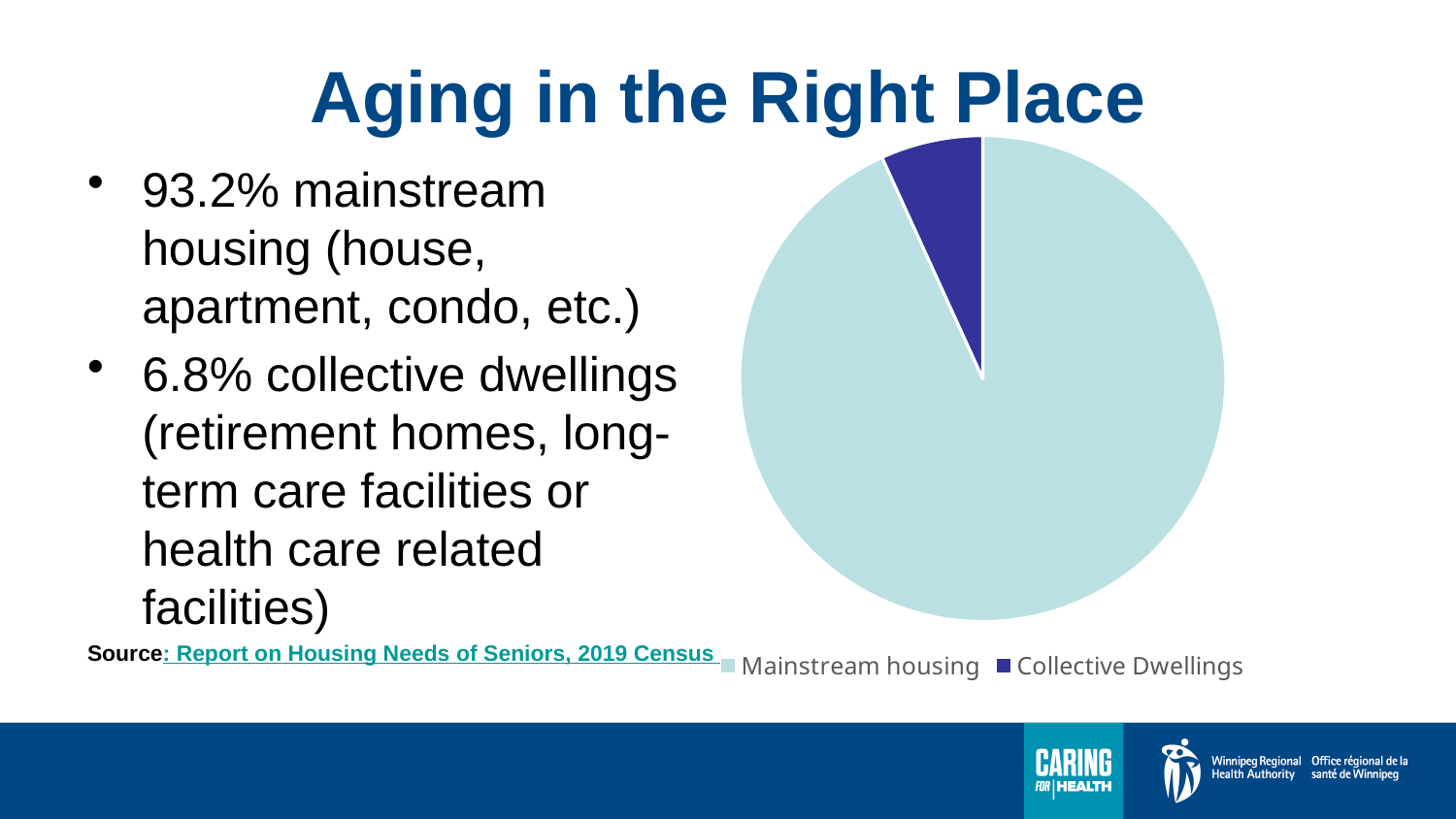
What kind of chart is shown on the slide? pie chart What colour is the Collective Dwellings slice in the pie chart? dark blue Which slice of the pie chart is the smallest? Collective Dwellings Which slice of the pie chart is the largest? Mainstream housing How many entries does the legend of the pie chart list? 2 What share of the pie does Mainstream housing represent? 93.2% How many slices does the pie chart have? 2 Which is larger in the pie chart, Mainstream housing or Collective Dwellings? Mainstream housing What are the two legend entries of the pie chart? Mainstream housing and Collective Dwellings What share of the pie does Collective Dwellings represent? 6.8% Is the share for Collective Dwellings greater or less than 50%? less